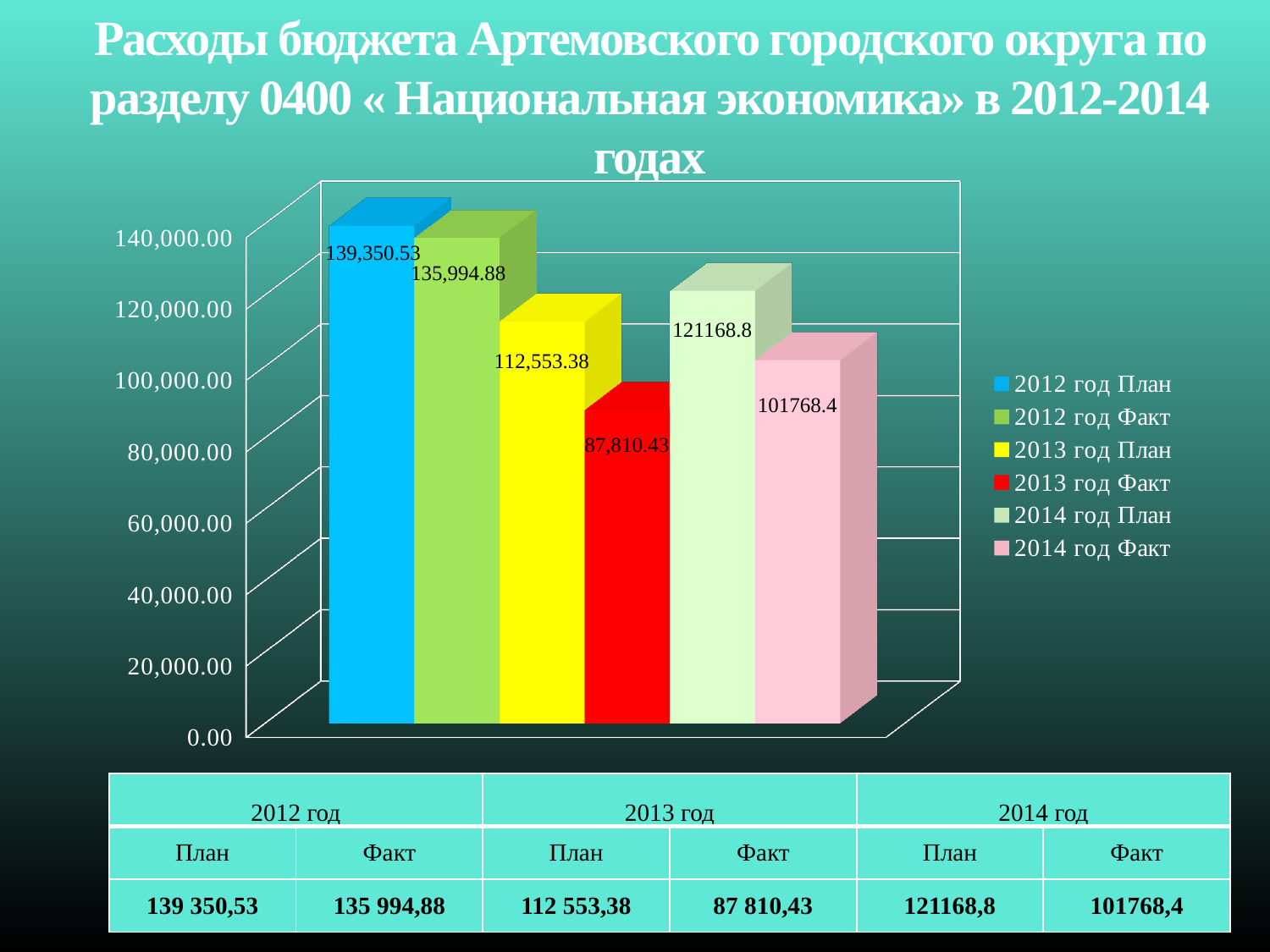
What is the difference between 2013 год План and 2013 год Факт? 24,742.95 Which series has the lowest value? 2013 год Факт What is the value for 2012 год План? 139,350.53 What kind of chart is shown on the slide? bar chart Which is larger, 2014 год План or 2013 год План? 2014 год План Which series has the highest value? 2012 год План What is the value for 2013 год Факт? 87,810.43 How many series does the legend list? 6 What is the value for 2014 год Факт? 101768.4 What is the value for 2014 год План? 121168.8 What is the difference between 2012 год План and 2012 год Факт? 3,355.65 Is the value for 2013 год Факт greater or less than 100,000.00? less